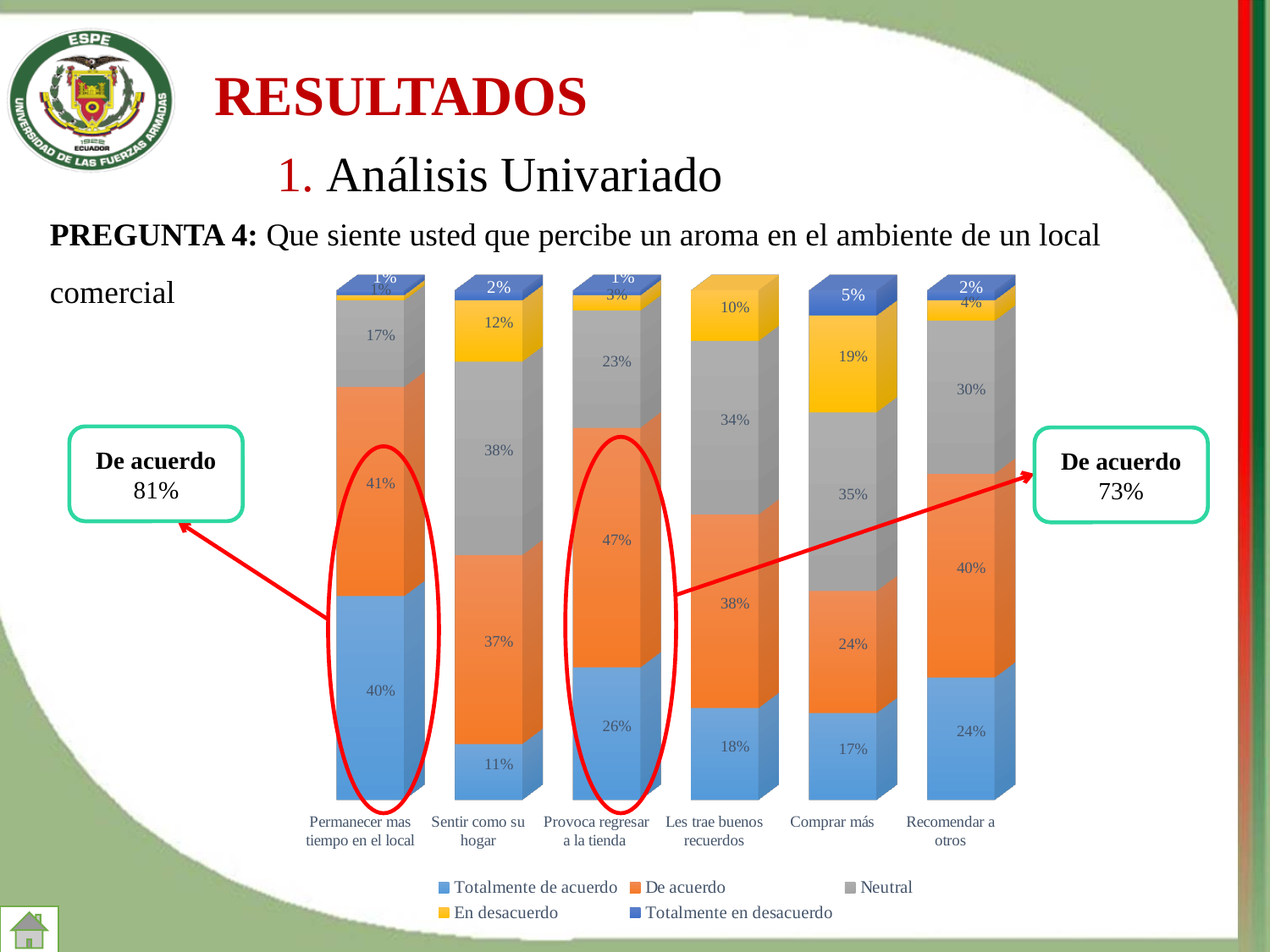
What is the 'Neutral' value for 'Comprar más'? 35% Which is larger: the 'Neutral' value for 'Sentir como su hogar' or for 'Recomendar a otros'? Sentir como su hogar What is the difference between the 'De acuerdo' values for 'Provoca regresar a la tienda' and 'Comprar más'? 23% Which category has the lowest 'Totalmente de acuerdo' value? Sentir como su hogar What type of chart is shown on the slide? stacked bar chart How many series does the chart legend list? 5 What is the 'En desacuerdo' value for 'Sentir como su hogar'? 12% What is the 'De acuerdo' value for 'Provoca regresar a la tienda'? 47% What is the 'Totalmente de acuerdo' value for 'Permanecer mas tiempo en el local'? 40% Which category has the highest 'Totalmente de acuerdo' value? Permanecer mas tiempo en el local How many categories are shown along the x axis of the chart? 6